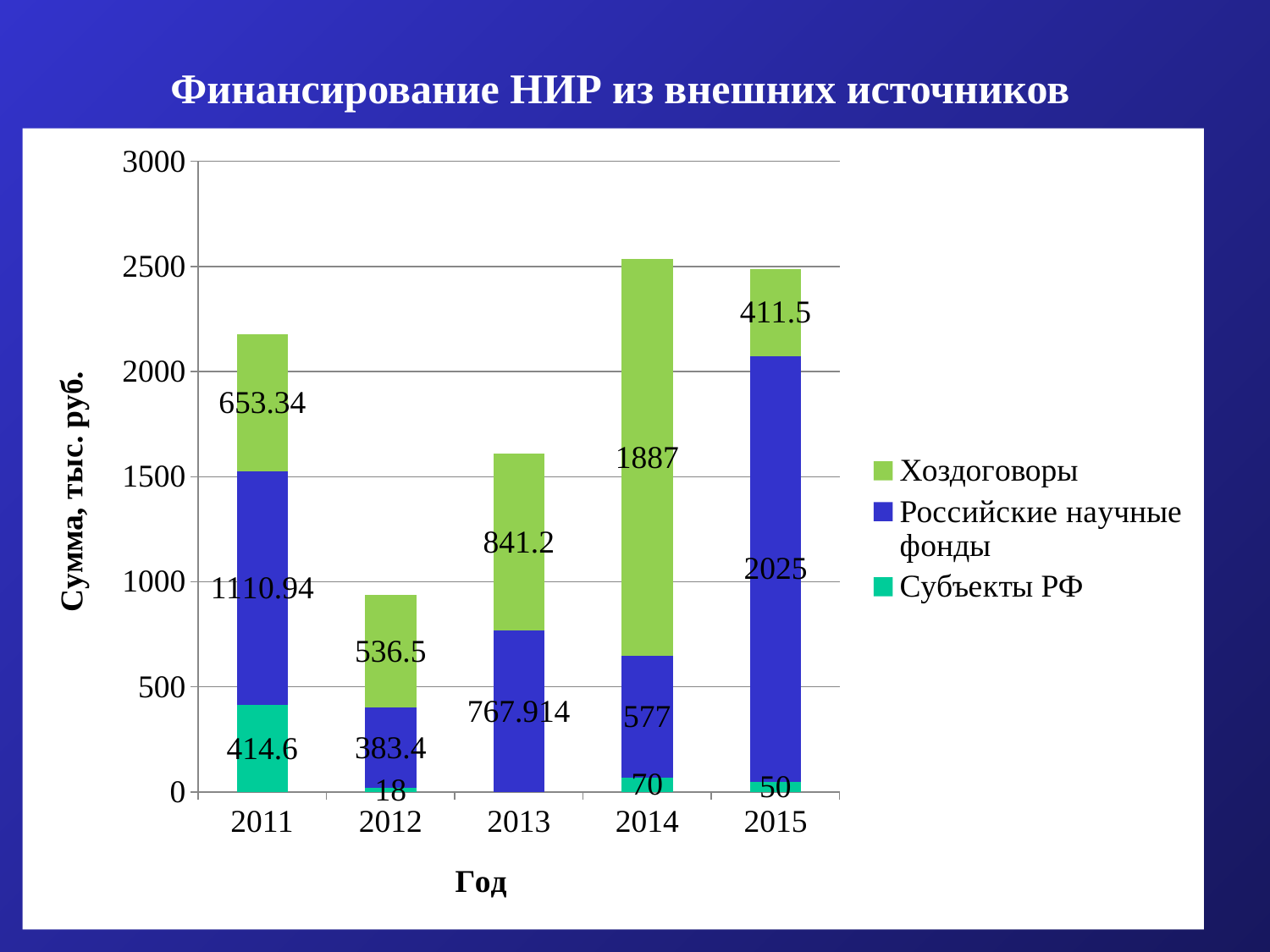
What is the value for Российские научные фонды in 2015? 2025 What is the value for Субъекты РФ in 2011? 414.6 In which year is the Хоздоговоры value the highest? 2014 What kind of chart is shown on the slide? stacked bar chart How many series does the legend list? 3 What is the value for Хоздоговоры in 2014? 1887 What is the difference between the Хоздоговоры values for 2013 and 2012? 304.7 In which year is the Российские научные фонды value the lowest? 2012 Is the total height of the 2012 bar greater or less than 1000? less Which year has the larger Российские научные фонды value, 2011 or 2015? 2015 What is the total of the stacked bar for 2014? 2534 How many years are shown on the x axis? 5